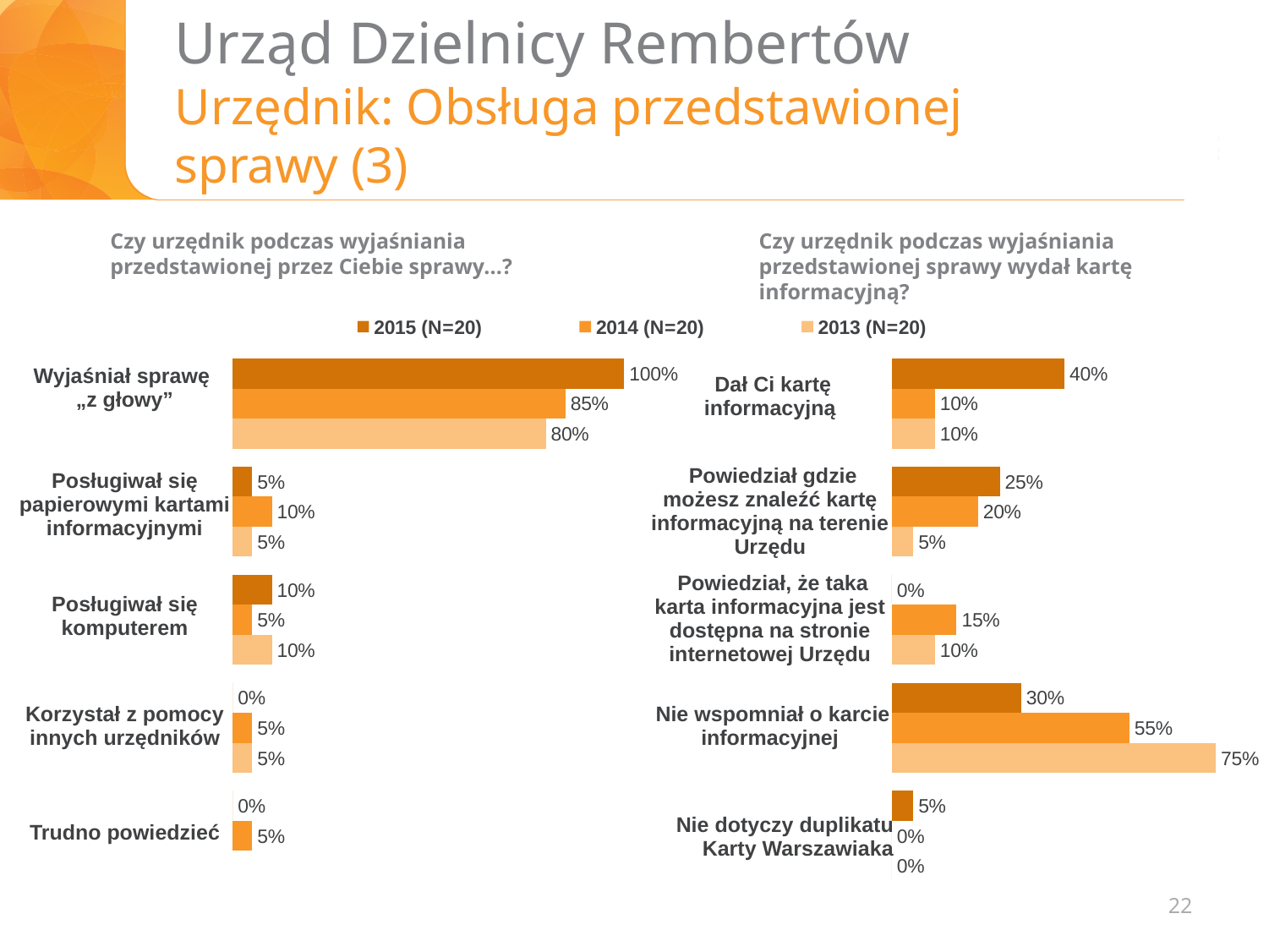
In the left chart, which category has the highest 2014 value? Wyjaśniał sprawę „z głowy” In the right chart, what is the 2014 value for "Nie wspomniał o karcie informacyjnej"? 55% In the right chart, is the 2015 value for "Powiedział gdzie możesz znaleźć kartę informacyjną na terenie Urzędu" larger or smaller than the 2013 value? larger In the right chart, which category has the highest 2013 value? Nie wspomniał o karcie informacyjnej How many series does the legend list? 3 In the left chart, what is the 2013 value for "Posługiwał się komputerem"? 10% In the right chart, what is the difference between the 2013 and 2015 values for "Nie wspomniał o karcie informacyjnej"? 45% How many categories does the right chart show? 5 What kind of chart is the left chart? bar chart In the left chart, what is the 2015 value for "Wyjaśniał sprawę „z głowy”"? 100% In the left chart, what is the difference between the 2015 and 2013 values for "Wyjaśniał sprawę „z głowy”"? 20% In the right chart, what is the 2015 value for "Dał Ci kartę informacyjną"? 40%